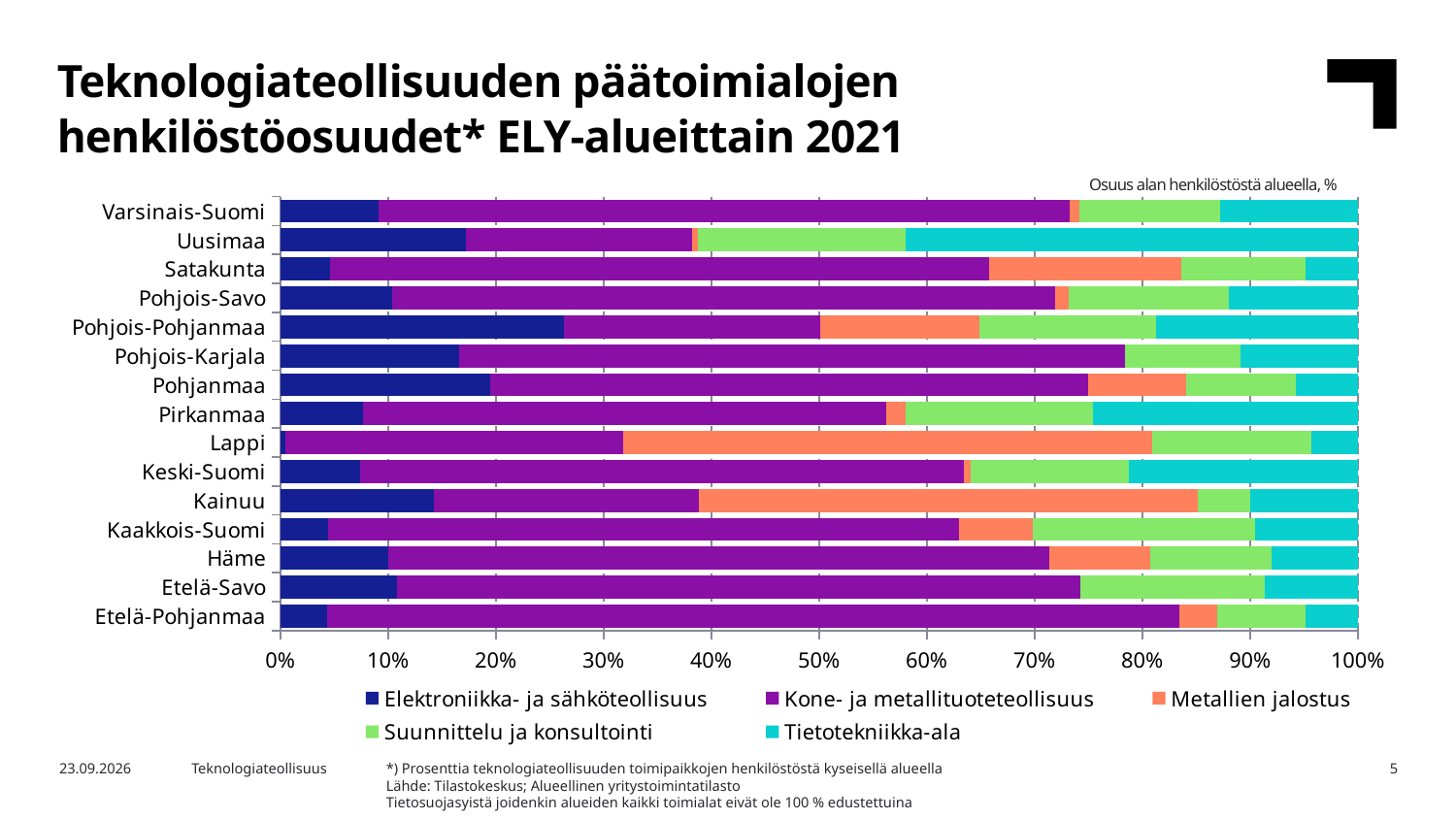
Which is larger: the Metallien jalostus share for Lappi or for Satakunta? Lappi Is the Elektroniikka- ja sähköteollisuus share for Varsinais-Suomi greater or less than 10%? less How many ELY regions are listed on the vertical axis of the chart? 15 Is the Kone- ja metallituoteteollisuus share for Uusimaa greater or less than 30%? less What kind of chart is shown on the slide? Stacked bar chart Which region has the largest share for Tietotekniikka-ala? Uusimaa Is the Metallien jalostus share for Lappi greater or less than 40%? greater Which is larger: the Tietotekniikka-ala share for Uusimaa or for Varsinais-Suomi? Uusimaa What is the title of the chart on the slide? Teknologiateollisuuden päätoimialojen henkilöstöosuudet* ELY-alueittain 2021 Which region has the largest share for Elektroniikka- ja sähköteollisuus? Pohjois-Pohjanmaa How many series does the chart legend list? 5